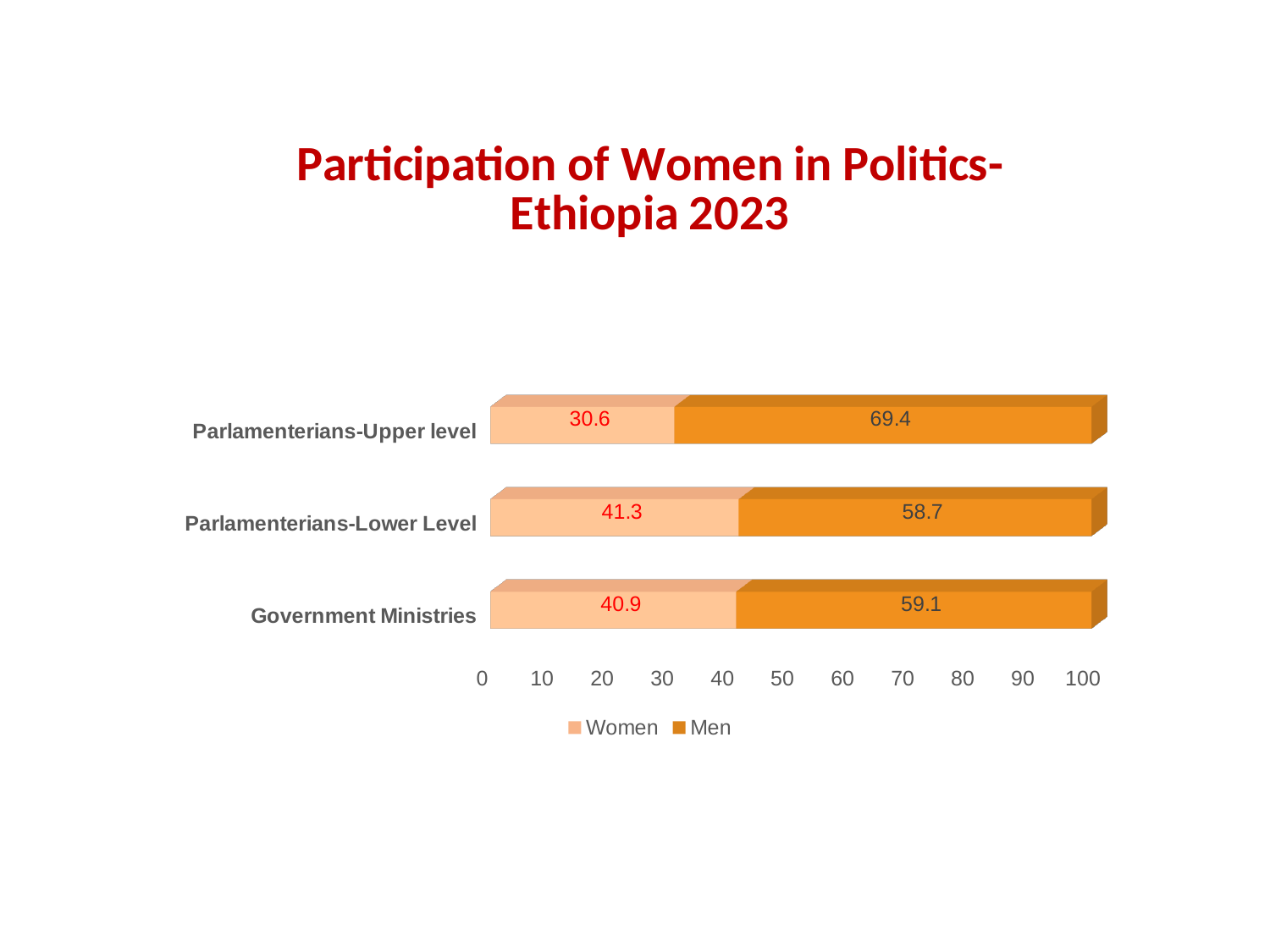
What is the total of the stacked bar for Parlamenterians-Lower Level? 100 Which category has the highest Men value? Parlamenterians-Upper level How many series does the legend list? 2 Is the Women value for Government Ministries larger or smaller than the Women value for Parlamenterians-Upper level? larger Which category has the lowest Women value? Parlamenterians-Upper level What is the Women value for Parlamenterians-Upper level? 30.6 What is the Men value for Government Ministries? 59.1 What is the difference between the Men and Women values for Parlamenterians-Upper level? 38.8 What is the title of the chart? Participation of Women in Politics- Ethiopia 2023 How many categories are shown on the chart? 3 What kind of chart is shown on the slide? stacked bar chart What is the Women value for Parlamenterians-Lower Level? 41.3